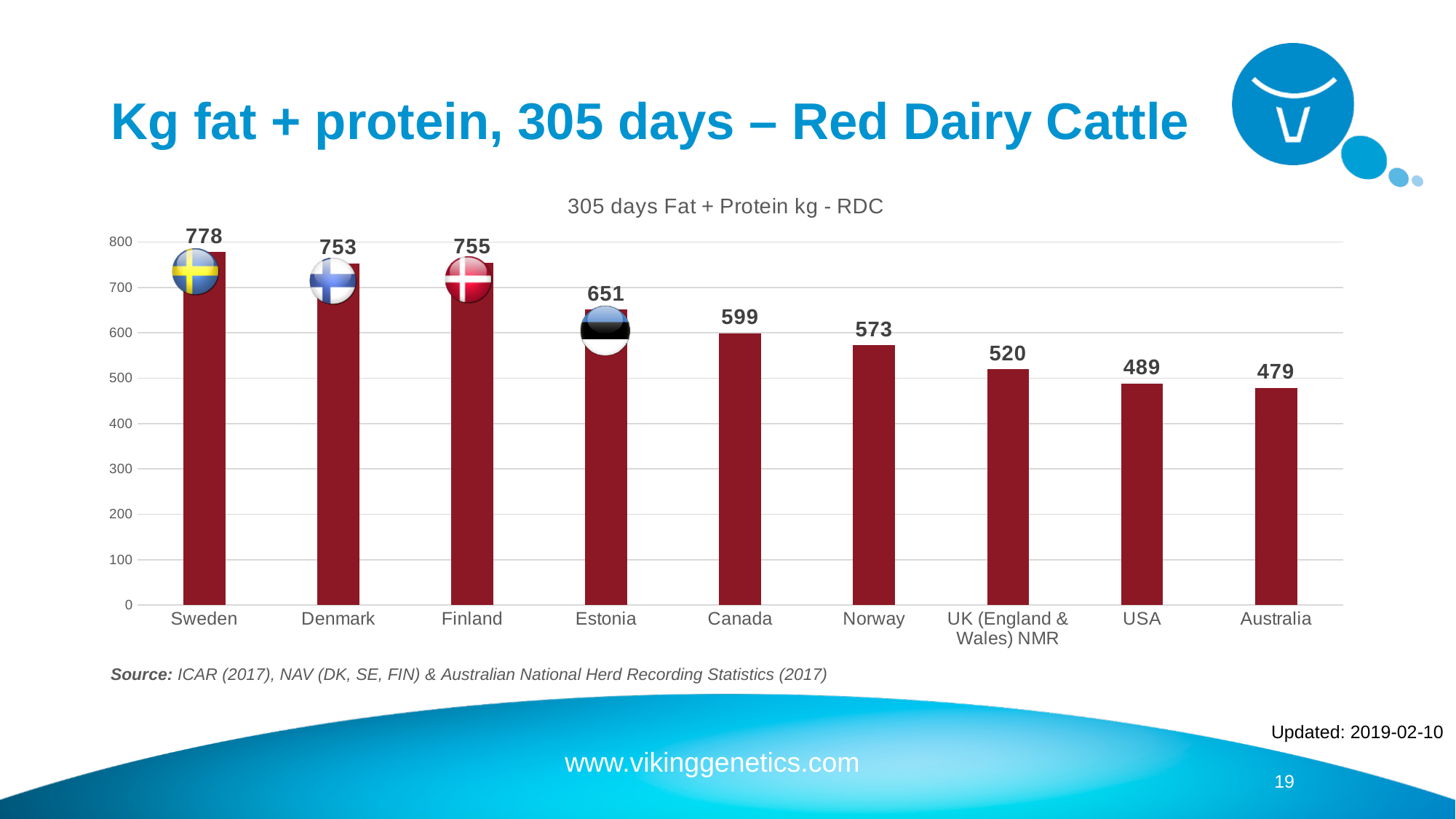
Which country has the lowest value? Australia Is the value for USA greater or less than 500? less What kind of chart is shown on the slide? bar chart How many countries are shown on the chart? 9 What is the title of the chart? 305 days Fat + Protein kg - RDC What is the value for Sweden? 778 What is the value for UK (England & Wales) NMR? 520 What is the difference between the values for Canada and Norway? 26 Which country has the highest value? Sweden What is the value for Estonia? 651 Which is larger, the value for Finland or the value for Denmark? Finland What is the difference between the values for Sweden and Australia? 299